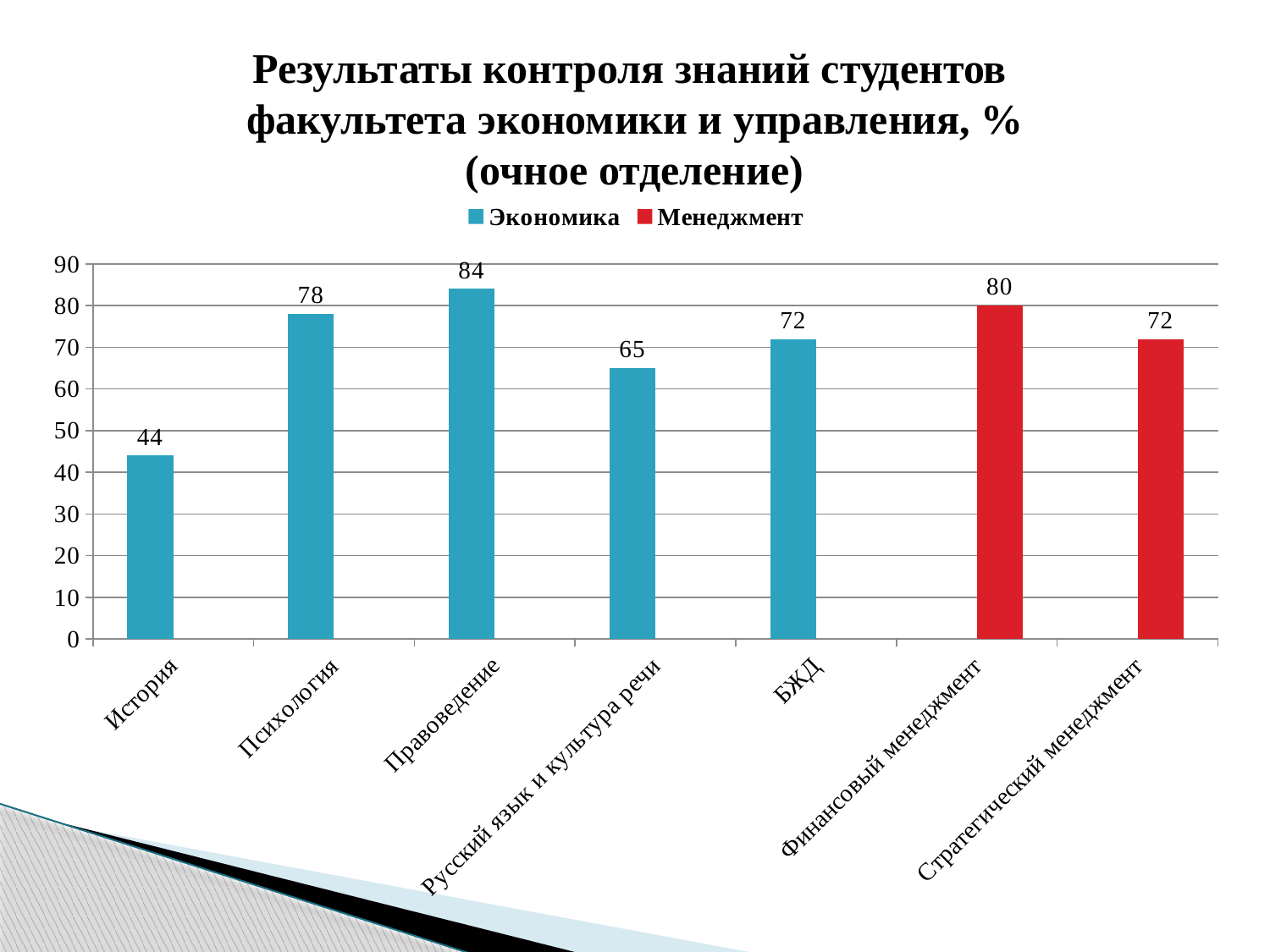
How many categories are shown on the x axis? 7 What is the value for Русский язык и культура речи? 65 How many series does the legend list? 2 What is the value for Финансовый менеджмент? 80 What is the difference between the values for Правоведение and История? 40 What is the value for Правоведение? 84 Which category has the highest value? Правоведение What is the value for История? 44 Which category has the lowest value? История Which is larger, the value for Психология or the value for Финансовый менеджмент? Финансовый менеджмент Which series is shown in red? Менеджмент What kind of chart is shown on the slide? bar chart